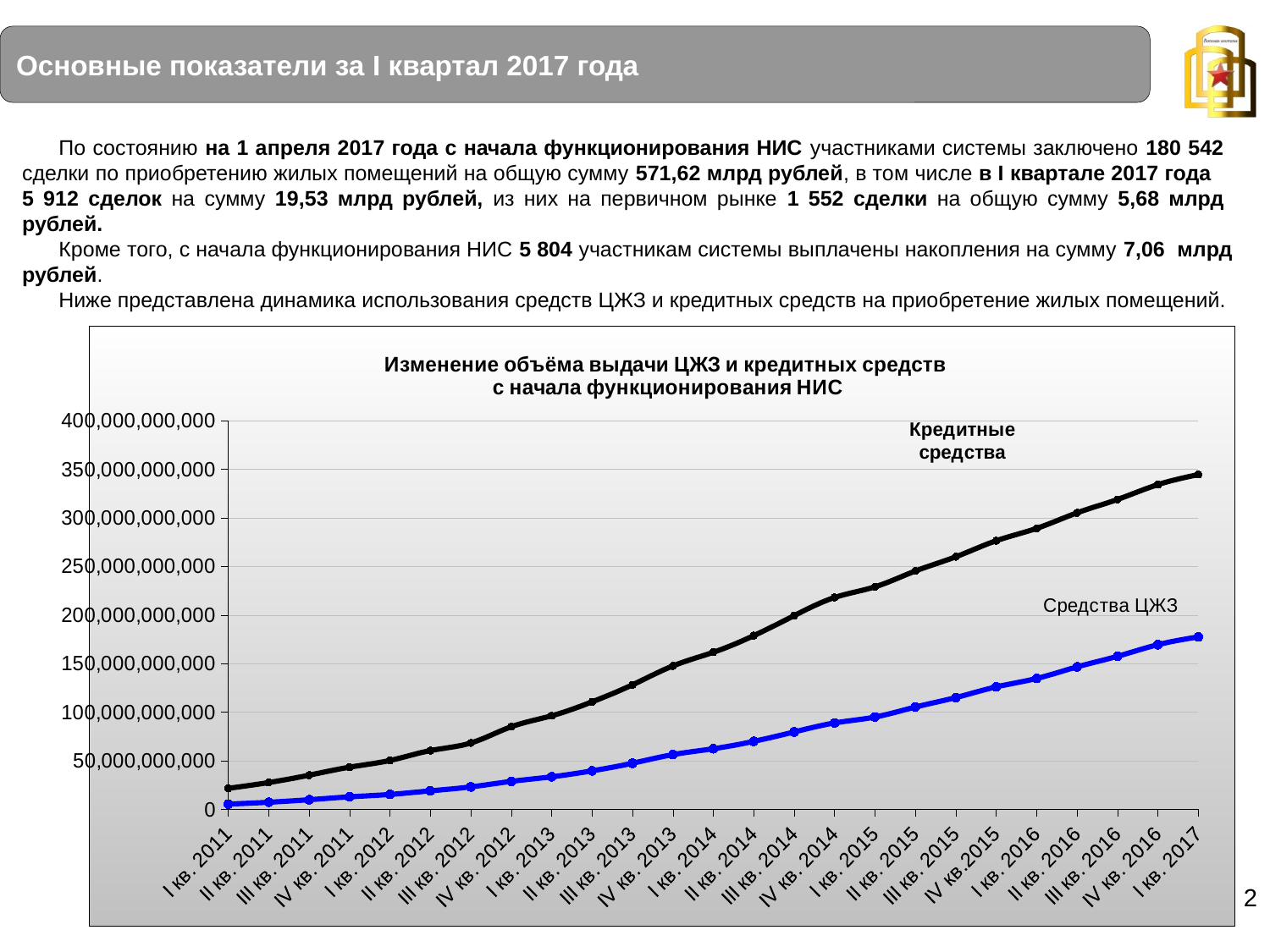
How many quarters (points) are shown along the x axis of the chart? 25 Do the values for Средства ЦЖЗ rise or fall along the x axis? rise What is the title of the chart? Изменение объёма выдачи ЦЖЗ и кредитных средств с начала функционирования НИС What kind of chart is shown on the slide? line chart At which quarter does Кредитные средства reach its highest value? I кв. 2017 Which series is drawn with the blue line? Средства ЦЖЗ At I кв. 2017, which series has the larger value, Кредитные средства or Средства ЦЖЗ? Кредитные средства Is the value for Кредитные средства at I кв. 2017 greater or less than 300,000,000,000? greater Do the values for Кредитные средства rise or fall from I кв. 2011 to I кв. 2017? rise How many data series are plotted on the chart? 2 At which quarter is the value for Средства ЦЖЗ lowest? I кв. 2011 Is the value for Средства ЦЖЗ at I кв. 2017 greater or less than 200,000,000,000? less